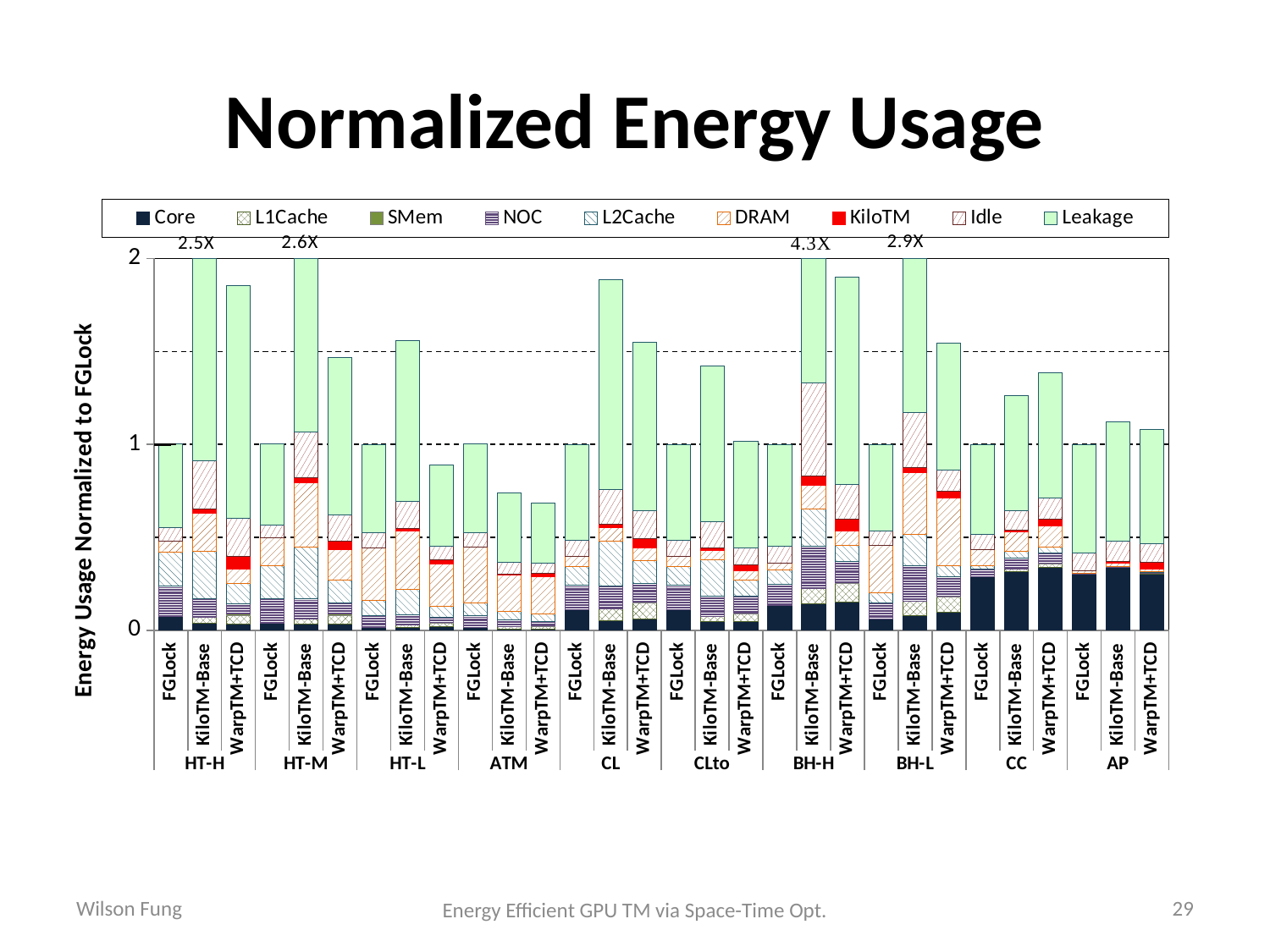
What kind of chart is shown on the slide? Stacked bar chart Which is larger: the total for WarpTM+TCD in HT-H or the total for WarpTM+TCD in HT-L? WarpTM+TCD in HT-H What value is annotated above the KiloTM-Base bar for BH-H? 4.3X Is the total normalized energy usage for WarpTM+TCD in CC greater or less than 1? greater How many bars are plotted in total on the chart? 30 How many series does the legend list? 9 Among the bars with annotated values, which bar has the highest normalized energy usage? KiloTM-Base for BH-H (4.3X) Is the total normalized energy usage for WarpTM+TCD in ATM greater or less than 1? less What is the title of the y axis? Energy Usage Normalized to FGLock What value is annotated above the KiloTM-Base bar for HT-M? 2.6X How many benchmark groups (HT-H, HT-M, etc.) are shown along the x axis? 10 What value is annotated above the KiloTM-Base bar for HT-H? 2.5X